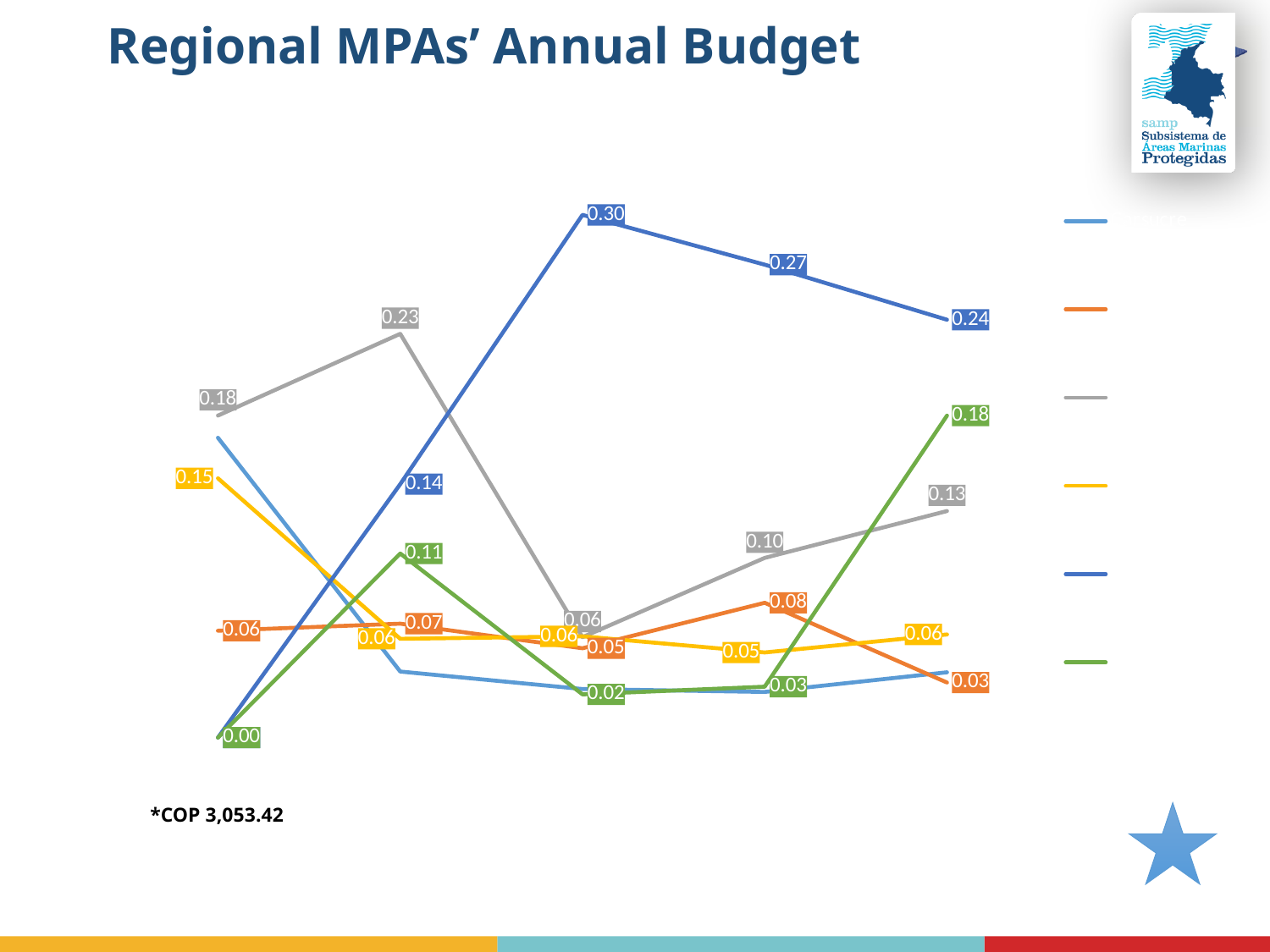
What is the value of the dark blue line at its last (fifth) point? 0.24 What type of chart is shown on the slide? line chart What is the value of the green line at its last (fifth) point? 0.18 What is the value of the grey line at its second point? 0.23 At the last point, which is larger: the green line (0.18) or the grey line (0.13)? the green line How many series does the legend list? 6 Does the dark blue line rise or fall from its third point to its fifth point? falls How many data points does each line have along the x axis? 5 What is the highest data label shown on the chart? 0.30 What is the title of the chart? Regional MPAs' Annual Budget What is the lowest data label shown on the chart? 0.00 What is the difference between the dark blue line's third point (0.30) and its fourth point (0.27)? 0.03